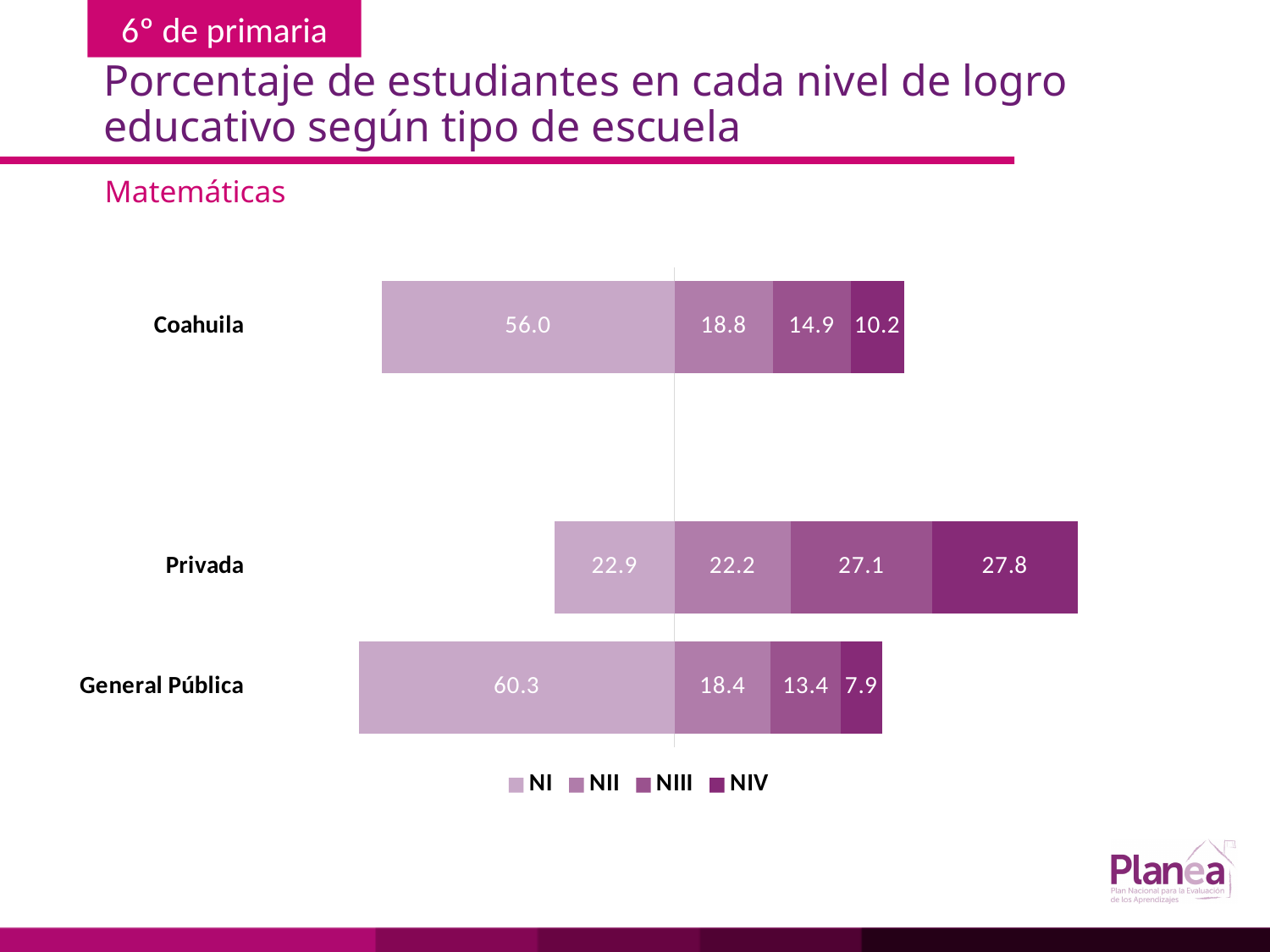
What kind of chart is shown on the slide? Stacked bar chart Which category has the highest NI value? General Pública What is the NI value for Coahuila? 56.0 What is the difference between the NI values for General Pública and Privada? 37.4 What is the NIII value for General Pública? 13.4 How many series does the legend list? 4 How many categories are shown in the chart? 3 Which category has the lowest NIV value? General Pública Which is larger, the NIII value for Privada or the NIII value for Coahuila? Privada What subject is named above the chart? Matemáticas What is the NIV value for Privada? 27.8 What is the total of the stacked bar for Privada? 100.0